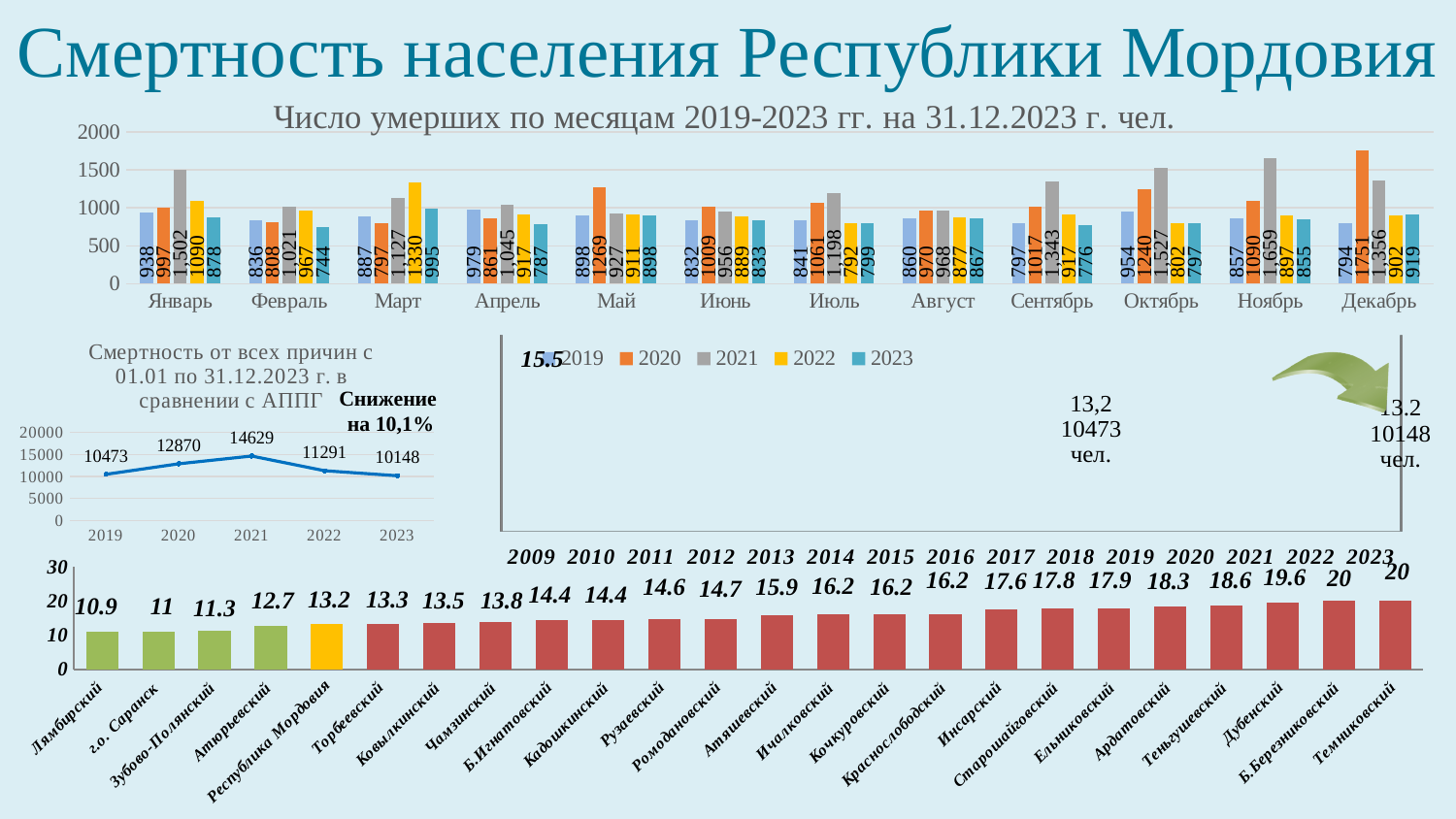
In the top chart 'Число умерших по месяцам 2019-2023 гг.', what is the difference between the 2021 and 2019 values for Ноябрь? 802 In the top chart 'Число умерших по месяцам 2019-2023 гг.', which is larger for Январь: the 2021 value or the 2023 value? 2021 In the line chart 'Смертность от всех причин с 01.01 по 31.12.2023 г.', which year has the lowest value? 2023 What kind of chart is the bottom chart of districts? bar chart In the top chart 'Число умерших по месяцам 2019-2023 гг.', how many series does the legend list? 5 In the bottom bar chart of districts, which district has the lowest value? Лямбирский In the bottom bar chart of districts, how many categories are shown? 24 In the line chart 'Смертность от всех причин с 01.01 по 31.12.2023 г.', what is the difference between the 2022 and 2023 values? 1143 In the top chart 'Число умерших по месяцам 2019-2023 гг.', what is the value for Декабрь in the 2020 series? 1751 In the top chart 'Число умерших по месяцам 2019-2023 гг.', what is the value for Март in the 2022 series? 1330 In the bottom bar chart of districts, what is the value for Республика Мордовия? 13.2 In the line chart 'Смертность от всех причин с 01.01 по 31.12.2023 г.', what is the value for 2021? 14629